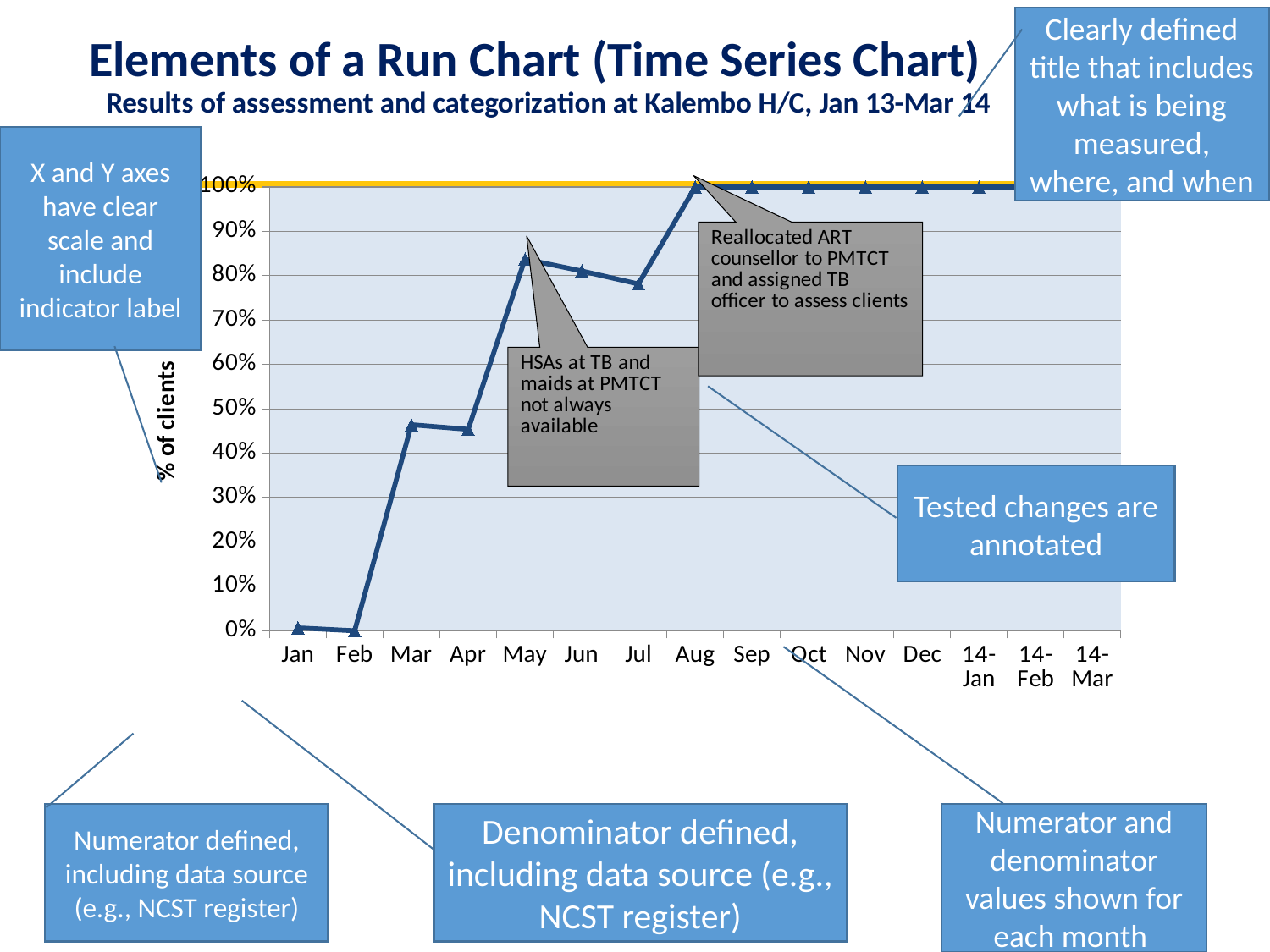
Overall, do the values rise or fall from Jan to Aug? rise Is the value for May greater or less than 70%? greater Is the value for Jul greater or less than 70%? greater How many months (data points) are plotted along the x axis? 15 Is the value for Mar greater or less than 40%? greater Which is larger, the value for Mar or the value for May? May Which month is annotated with 'Reallocated ART counsellor to PMTCT and assigned TB officer to assess clients'? Aug What kind of chart is shown on the slide? Line chart What is the label on the y axis of the chart? % of clients What is the value for Aug? 100% What is the value for Feb? 0%